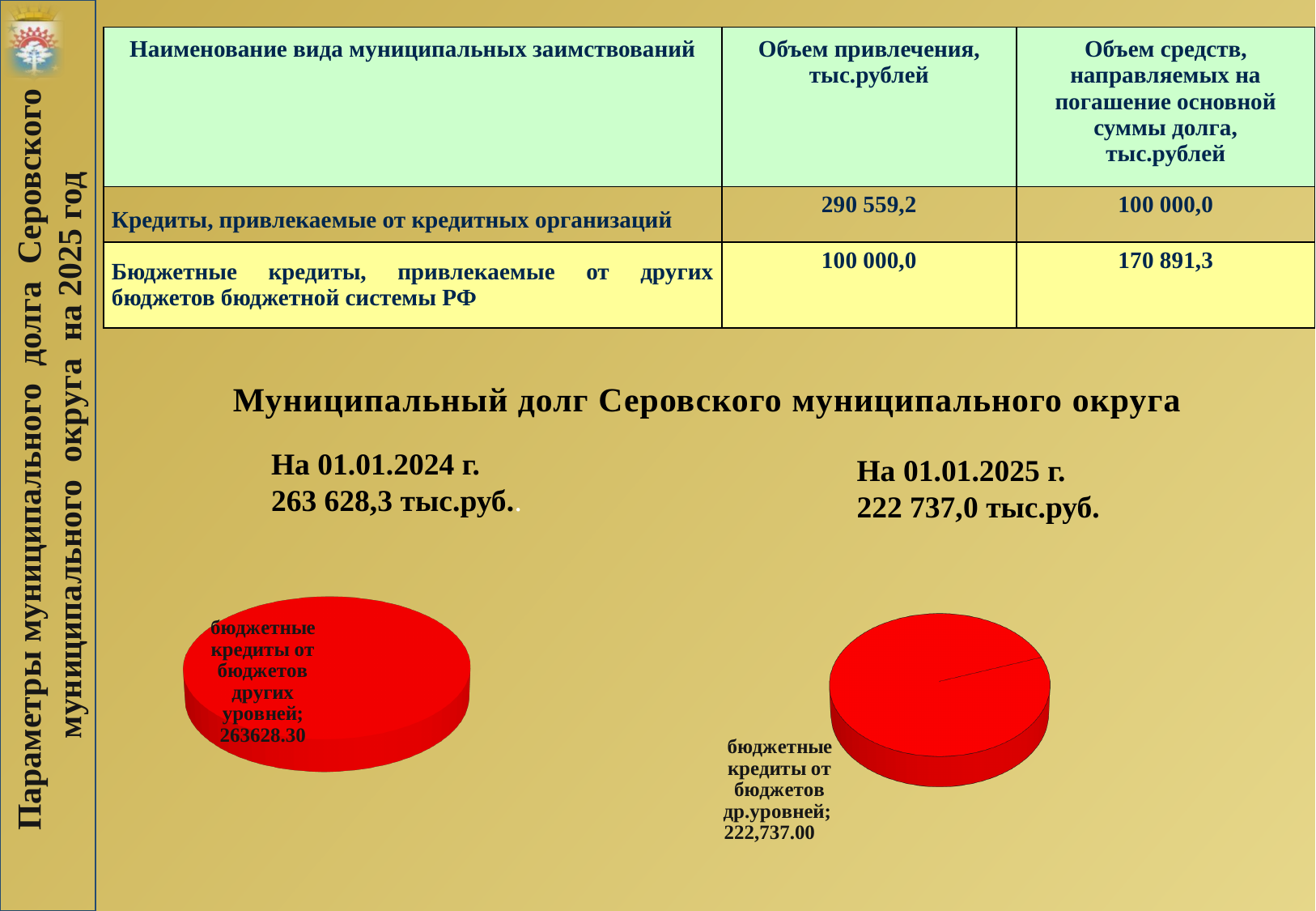
What kind of chart is the left chart on the slide (under 'На 01.01.2024 г.')? pie chart What is the category label of the single slice in the right pie chart (01.01.2025)? бюджетные кредиты от бюджетов др.уровней In the left pie chart (01.01.2024), what value is shown in the data label for 'бюджетные кредиты от бюджетов других уровней'? 263628.30 What colour is the slice in the left pie chart (01.01.2024)? red In the left pie chart (01.01.2024), what share of the pie does the 'бюджетные кредиты от бюджетов других уровней' slice represent? 100% Which is larger: the value labelled in the left pie chart (01.01.2024) or the value labelled in the right pie chart (01.01.2025)? the left pie chart (263628.30) How many slices does the left pie chart (01.01.2024) contain? 1 In the right pie chart (01.01.2025), what share of the pie does the 'бюджетные кредиты от бюджетов др.уровней' slice represent? 100% How many slices does the right pie chart (01.01.2025) contain? 1 What kind of chart is the right chart on the slide (under 'На 01.01.2025 г.')? pie chart In the right pie chart (01.01.2025), what value is shown in the data label for 'бюджетные кредиты от бюджетов др.уровней'? 222,737.00